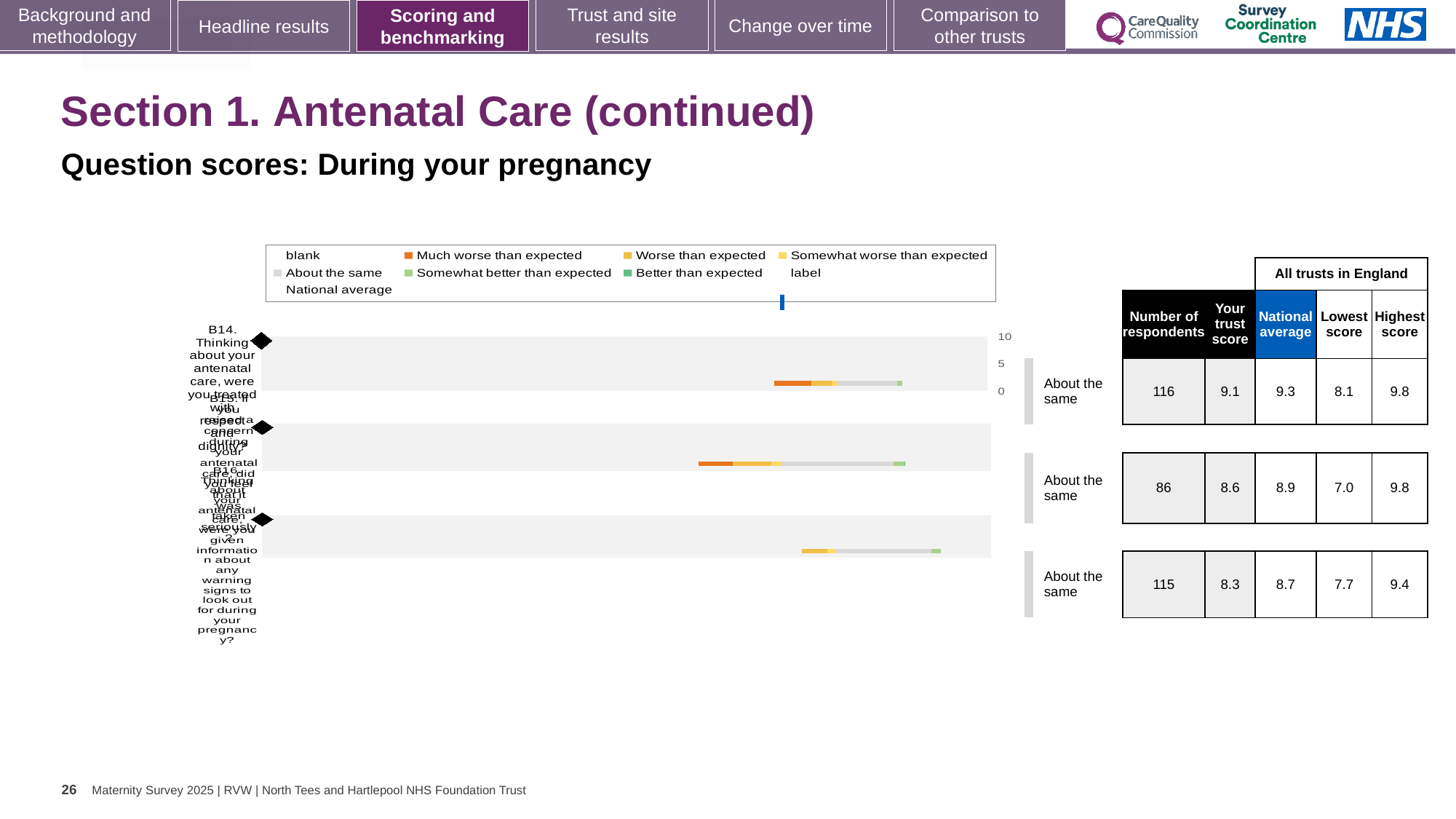
Which legend entry is shown in orange, immediately after 'blank'? Much worse than expected In the table beside the chart, what is the difference between the national average and the trust score for the first row (B14)? 0.2 What is the last entry listed in the chart legend? National average In the table beside the chart, what is the trust score for the first row (B14)? 9.1 How many bars (questions) are plotted in the chart? 3 What benchmark category is shown next to each of the three bars? About the same What kind of chart is shown on the slide? bar chart How many entries does the chart legend list? 9 In the table beside the chart, what is the number of respondents for the third row (B16)? 115 In the table beside the chart, which row has the lowest 'Your trust score'? the third row (B16), 8.3 In the table beside the chart, what is the national average for the second row (B15)? 8.9 In the table beside the chart, is the trust score for the second row (B15) larger or smaller than its national average? smaller